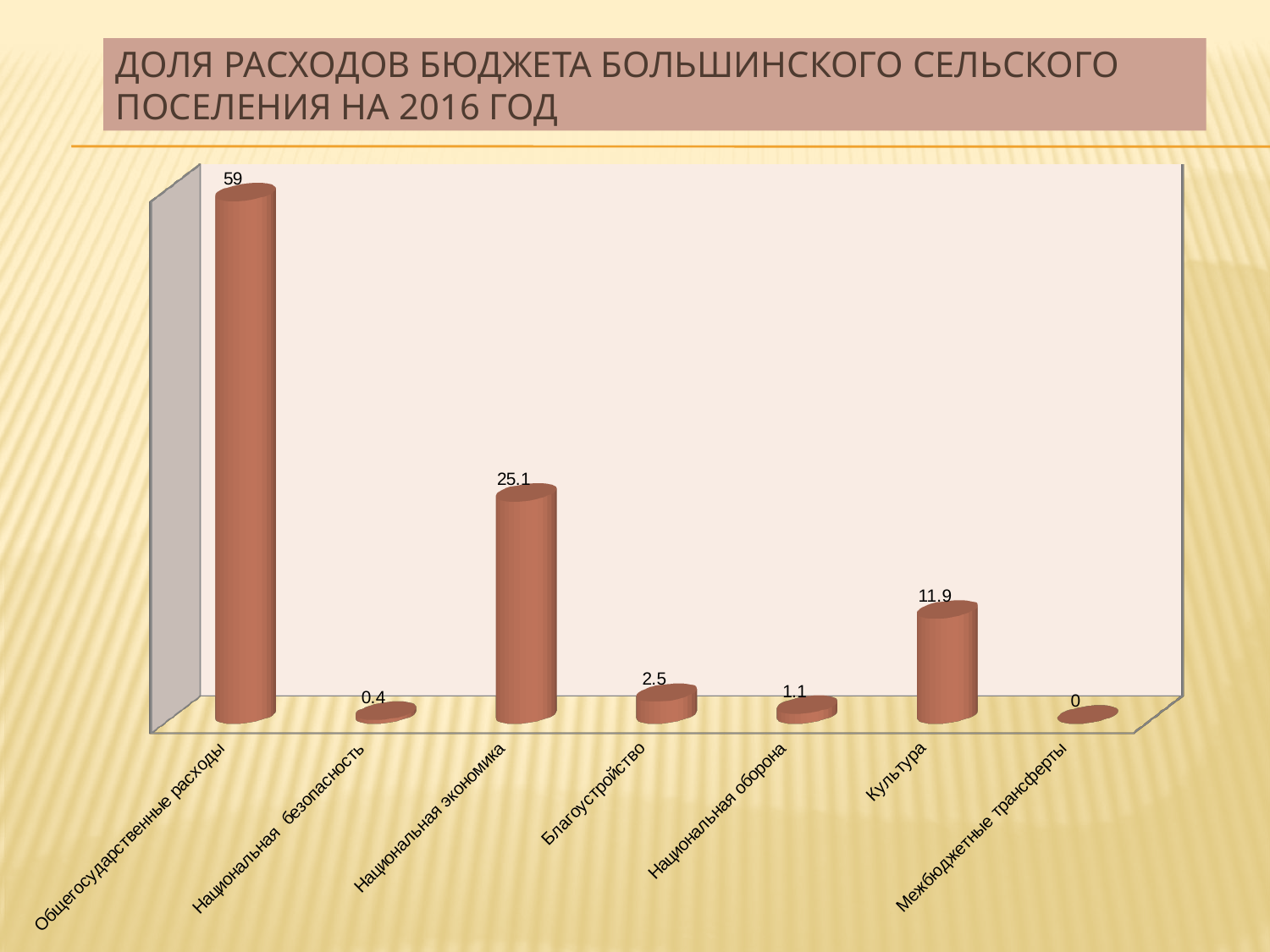
What is the value for Общегосударственные расходы? 59 What is the value for Культура? 11.9 What is the value for Национальная экономика? 25.1 What is the title of the slide? Доля расходов бюджета Большинского сельского поселения на 2016 год What is the difference between the values for Общегосударственные расходы and Национальная экономика? 33.9 What is the value for Благоустройство? 2.5 Which category has the lowest value? Межбюджетные трансферты Which category has the highest value? Общегосударственные расходы How many categories are shown on the chart? 7 What is the value for Межбюджетные трансферты? 0 Which is larger, the value for Благоустройство or the value for Национальная оборона? Благоустройство What kind of chart is shown on the slide? Bar chart